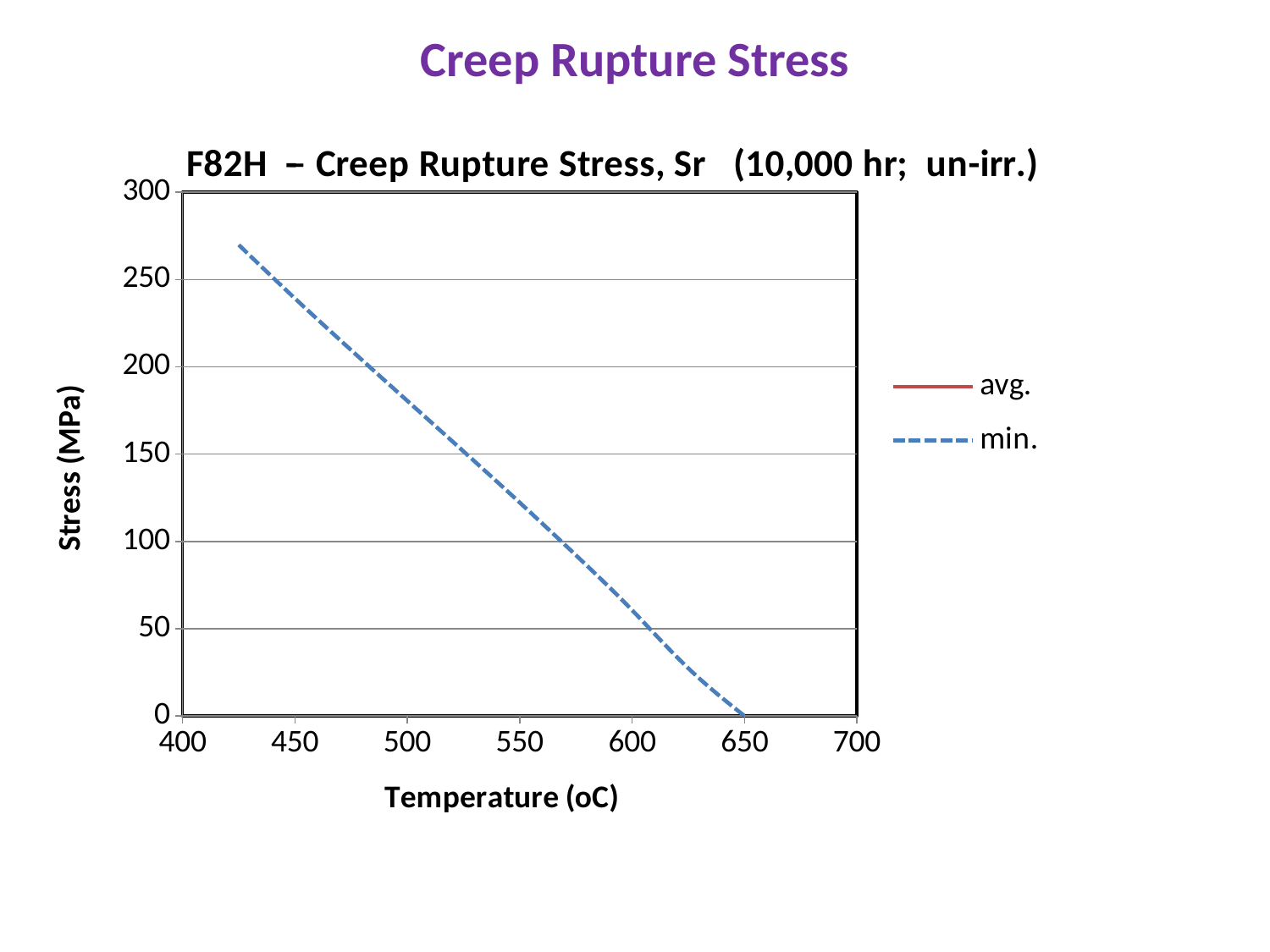
At what temperature does the min. line reach 0 MPa? 650 Does the min. stress rise or fall as temperature increases? fall Is the min. stress higher at 500 oC or at 600 oC? 500 oC Is the min. stress at 500 oC greater or less than 150 MPa? greater Is the min. stress at 600 oC greater or less than 100 MPa? less What is the title of the chart? F82H – Creep Rupture Stress, Sr (10,000 hr; un-irr.) Is the min. stress at 500 oC greater or less than 250 MPa? less Which series are listed in the legend? avg. and min. What kind of chart is shown on the slide? line chart How many series does the legend list? 2